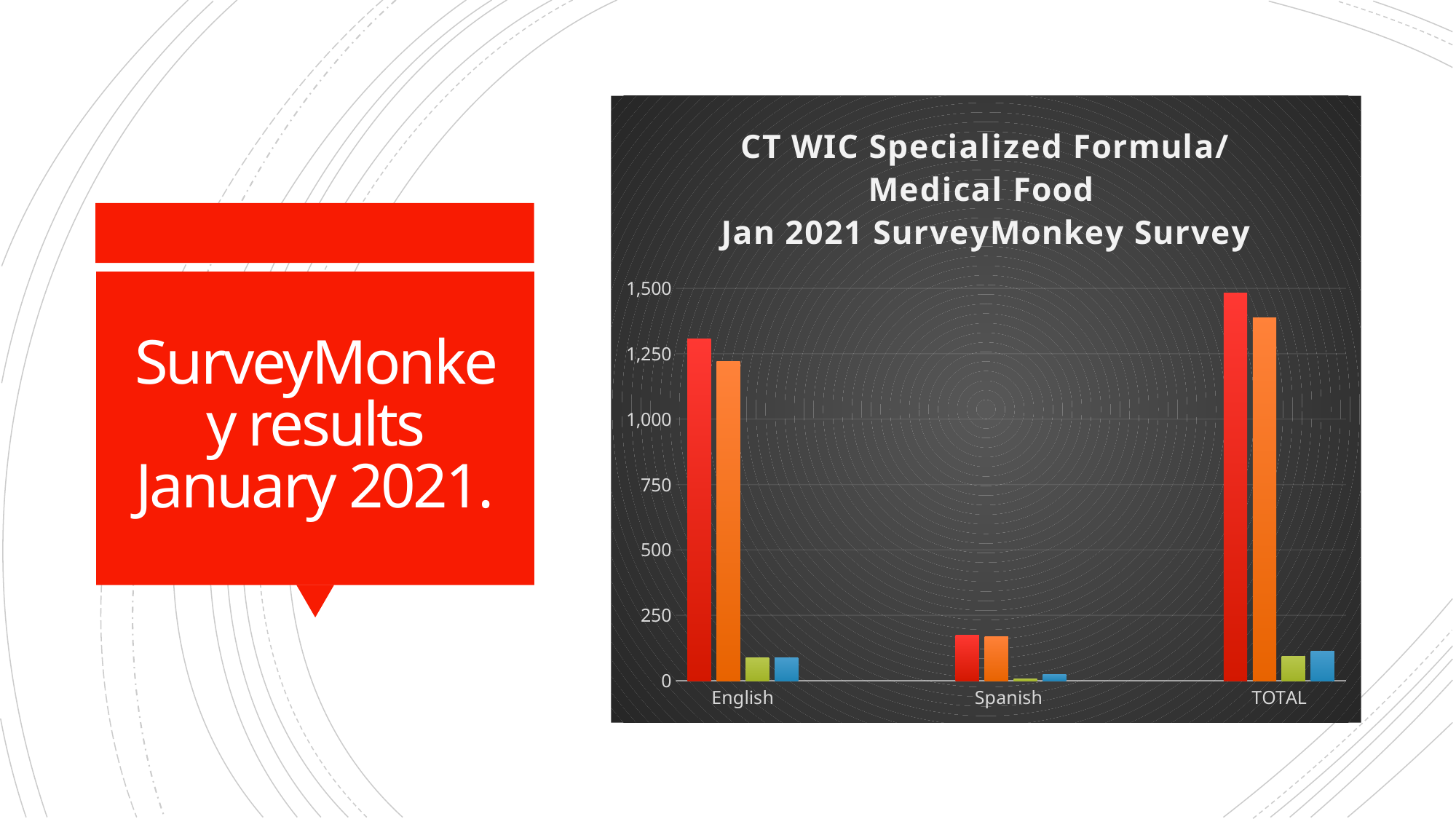
Which is larger, the red (first) bar for English or the red (first) bar for Spanish? English What kind of chart is shown on the slide? bar chart Which category has the shortest bars in the chart? Spanish How many categories are shown on the x axis of the chart? 3 What are the three categories on the x axis of the chart? English, Spanish, TOTAL Is the value of the orange (second) bar for English greater or less than 1,250? less Which is larger, the orange (second) bar for TOTAL or the orange (second) bar for English? TOTAL Which category has the tallest bar in the chart? TOTAL Is the value of the red (first) bar for English greater or less than 1,250? greater Is the value of the red (first) bar for Spanish greater or less than 250? less What is the title of the chart? CT WIC Specialized Formula/ Medical Food Jan 2021 SurveyMonkey Survey